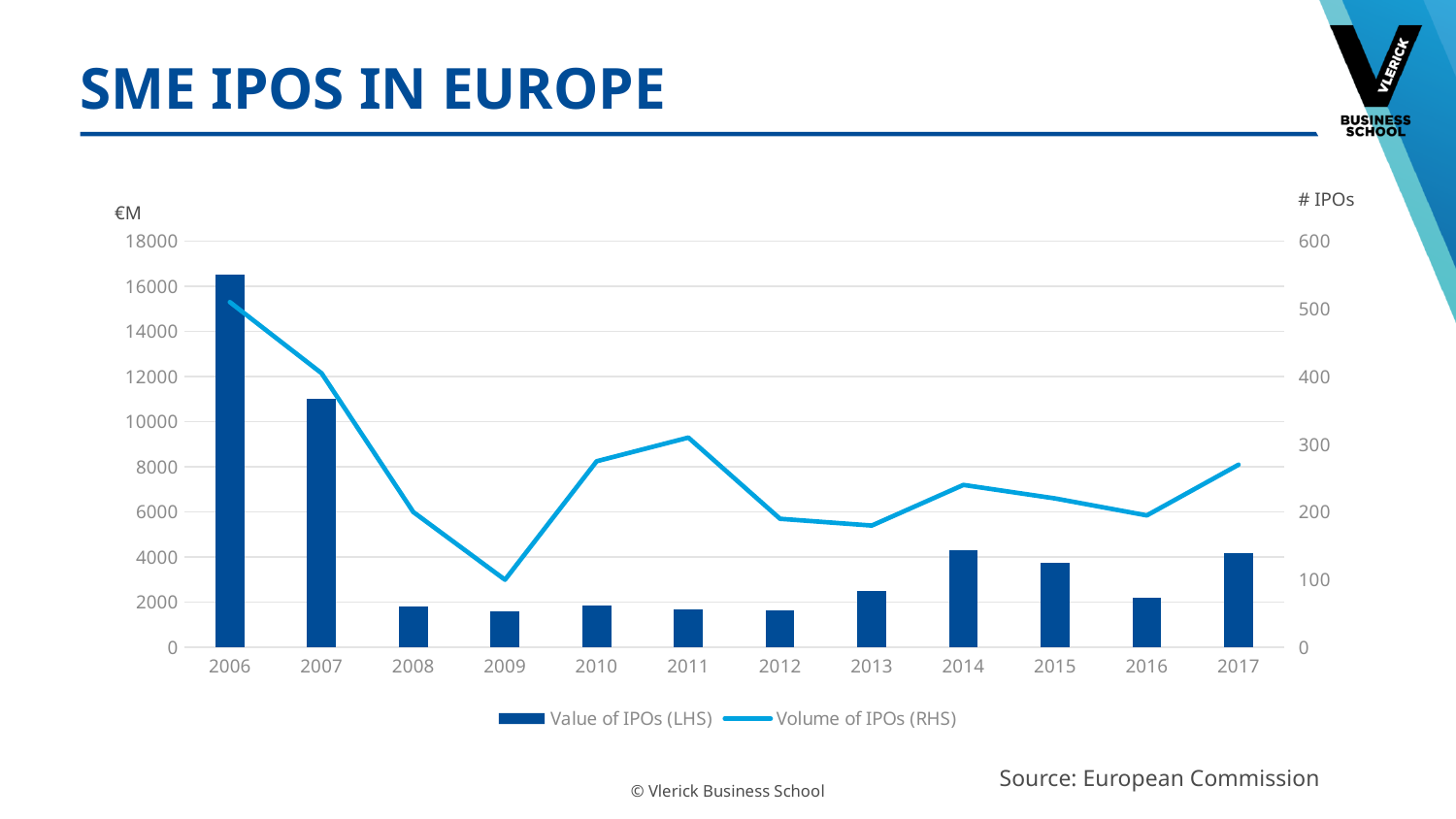
Does the Volume of IPOs (RHS) rise or fall from 2006 to 2009? fall How many series does the legend list? 2 What unit is shown above the left-hand axis of the chart? €M Which year has the lowest Volume of IPOs (RHS)? 2009 Which year has a larger Value of IPOs (LHS), 2014 or 2015? 2014 Which year has the highest Value of IPOs (LHS)? 2006 Which year has the highest Volume of IPOs (RHS)? 2006 Is the Value of IPOs (LHS) for 2007 greater or less than 10000? greater Is the Value of IPOs (LHS) for 2006 greater or less than 16000? greater What kind of chart is shown on the slide? A combined bar and line chart Is the Volume of IPOs (RHS) for 2009 greater or less than 200? less How many years are shown on the x axis of the chart? 12